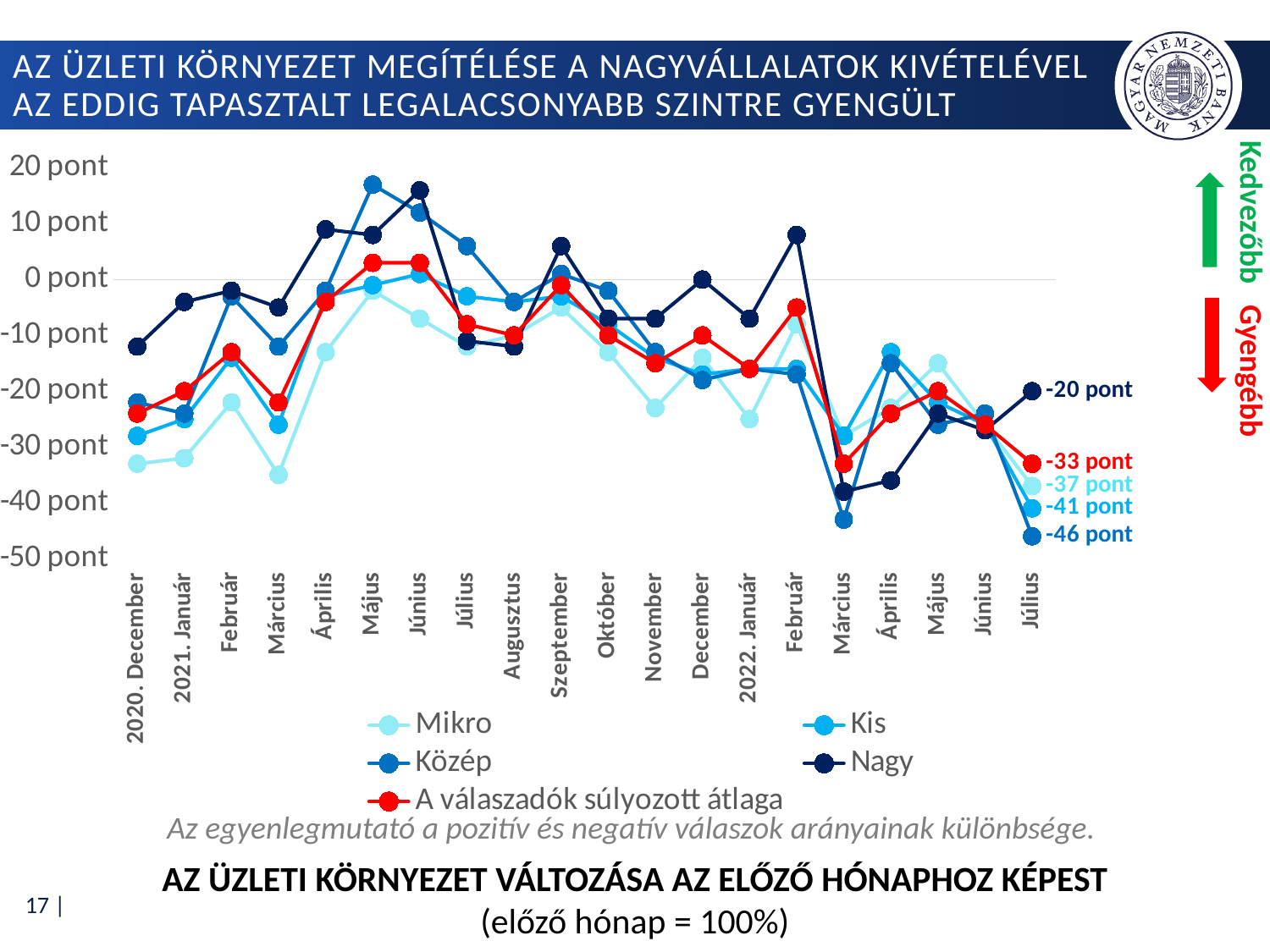
Which series has the lowest value in 2022 Július? Közép What kind of chart is shown on the slide? Line chart What is the value of the Kis series in 2022 Július? -41 pont How many series does the legend list? 5 What is the value of the Mikro series in 2022 Július? -37 pont What is the value of the Nagy series in 2022 Július? -20 pont Is the value of the Közép series in 2021 Május greater or less than 10 pont? greater What is the value of the Közép series in 2022 Július? -46 pont In 2022 Július, which is higher: Mikro or Kis? Mikro How many months are shown on the x axis? 20 What is the value of 'A válaszadók súlyozott átlaga' in 2022 Július? -33 pont What is the difference between the Nagy and Közép values in 2022 Július? 26 pont